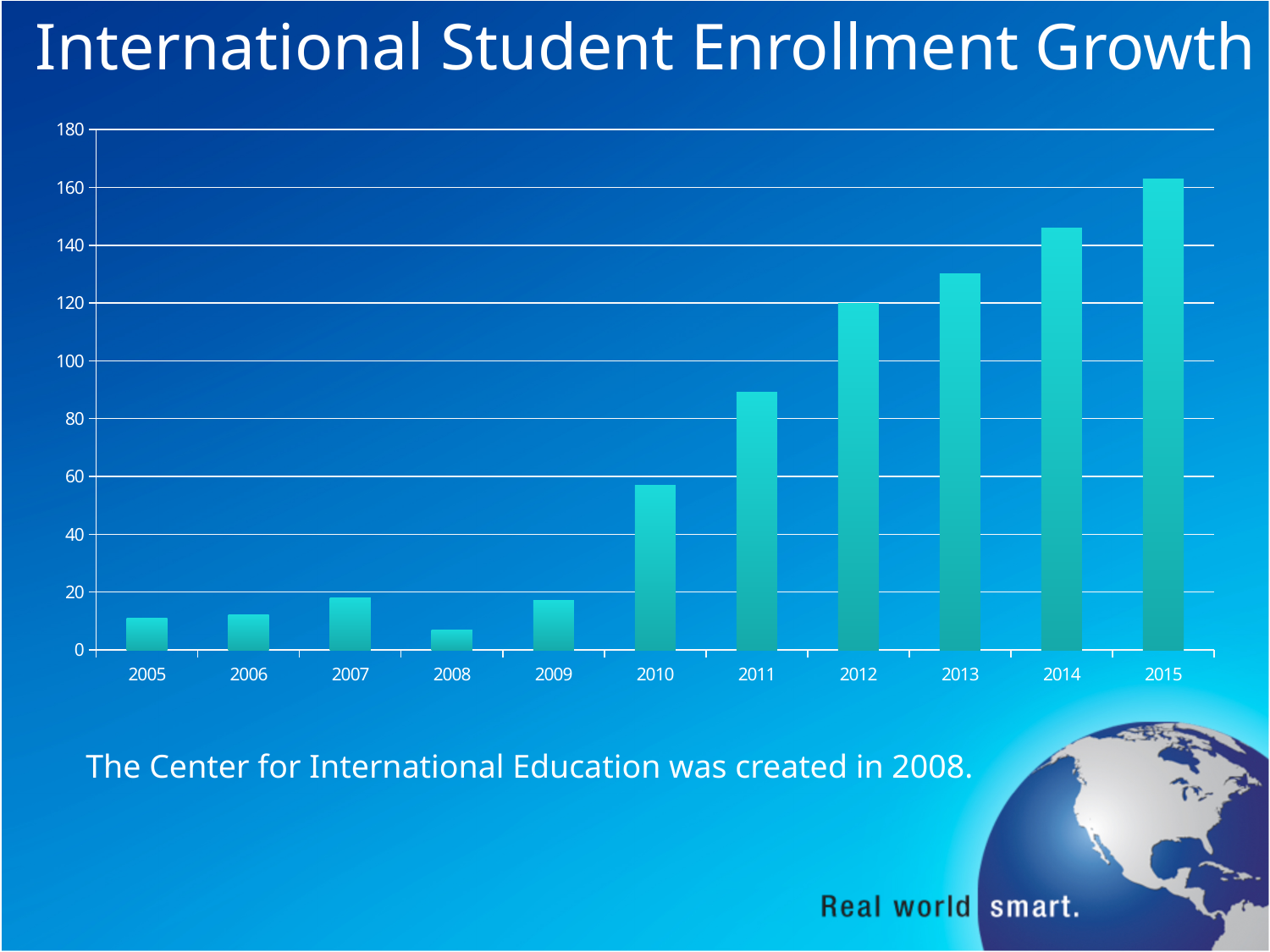
How many years are shown on the x axis? 11 Is the value for 2015 greater or less than 160? greater What kind of chart is shown on the slide? bar chart Is the value for 2010 greater or less than 60? less Is the value for 2011 greater or less than 80? greater Which is larger, the value for 2010 or the value for 2011? 2011 What is the title of the chart? International Student Enrollment Growth Do the values generally rise or fall from 2009 to 2015? rise Which year has the lowest bar? 2008 Which year has the highest bar? 2015